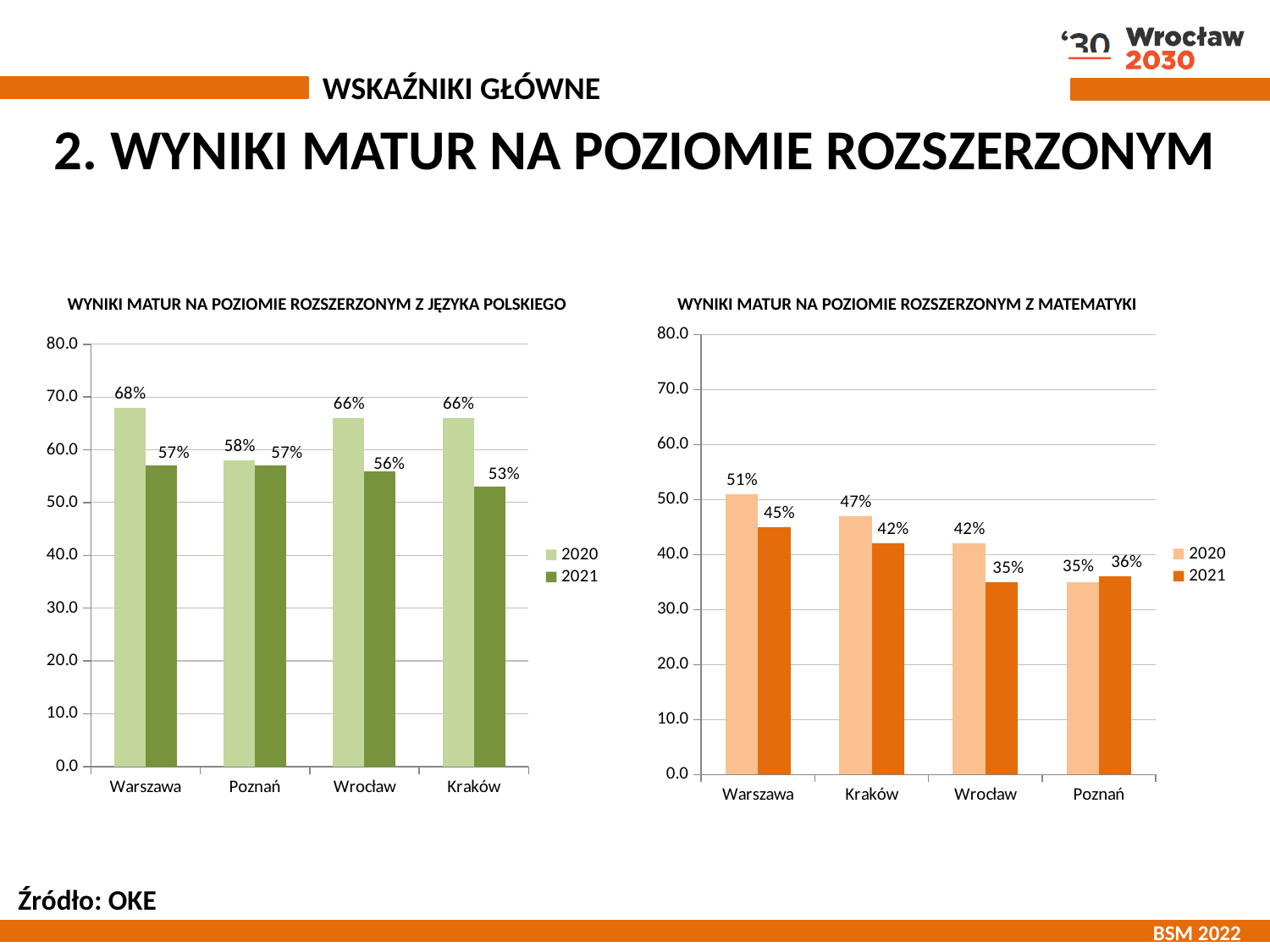
In the chart titled 'WYNIKI MATUR NA POZIOMIE ROZSZERZONYM Z JĘZYKA POLSKIEGO', how many cities are shown on the x axis? 4 In the chart titled 'WYNIKI MATUR NA POZIOMIE ROZSZERZONYM Z JĘZYKA POLSKIEGO', what is the value for Kraków in 2021? 53% In the chart titled 'WYNIKI MATUR NA POZIOMIE ROZSZERZONYM Z MATEMATYKI', how many series does the legend list? 2 In the chart titled 'WYNIKI MATUR NA POZIOMIE ROZSZERZONYM Z JĘZYKA POLSKIEGO', which city has the lowest value for 2021? Kraków In the chart titled 'WYNIKI MATUR NA POZIOMIE ROZSZERZONYM Z MATEMATYKI', which city has the highest value for 2021? Warszawa In the chart titled 'WYNIKI MATUR NA POZIOMIE ROZSZERZONYM Z JĘZYKA POLSKIEGO', which city has the highest value for 2020? Warszawa In the chart titled 'WYNIKI MATUR NA POZIOMIE ROZSZERZONYM Z JĘZYKA POLSKIEGO', what is the value for Warszawa in 2020? 68% In the chart titled 'WYNIKI MATUR NA POZIOMIE ROZSZERZONYM Z JĘZYKA POLSKIEGO', what is the difference between the 2020 and 2021 values for Warszawa? 11 percentage points In the chart titled 'WYNIKI MATUR NA POZIOMIE ROZSZERZONYM Z MATEMATYKI', what is the value for Wrocław in 2021? 35% What kind of chart is the chart titled 'WYNIKI MATUR NA POZIOMIE ROZSZERZONYM Z MATEMATYKI'? Bar chart In the chart titled 'WYNIKI MATUR NA POZIOMIE ROZSZERZONYM Z MATEMATYKI', is the 2020 value for Poznań larger or smaller than the 2021 value for Poznań? smaller In the chart titled 'WYNIKI MATUR NA POZIOMIE ROZSZERZONYM Z MATEMATYKI', what is the value for Kraków in 2020? 47%